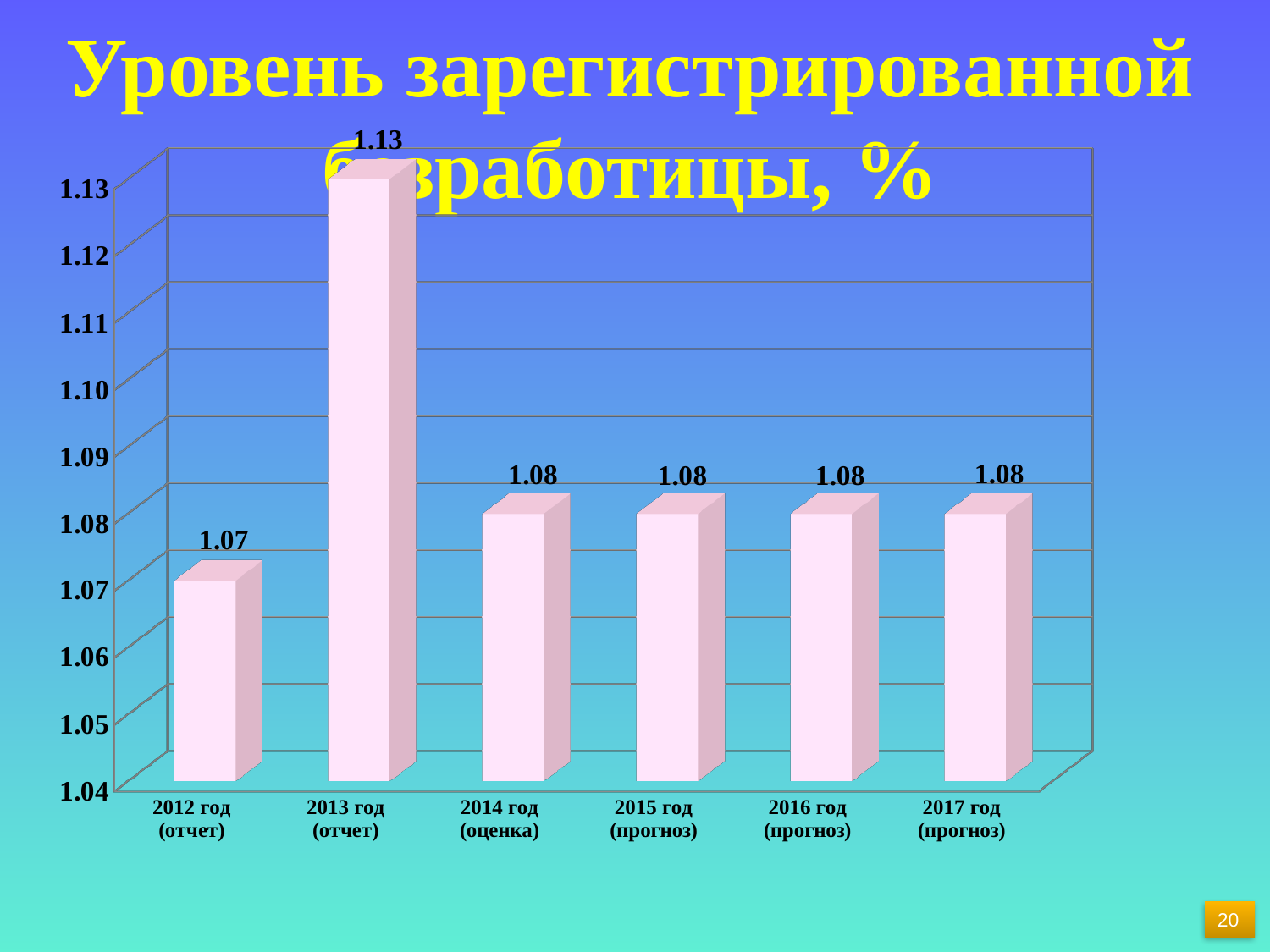
What is the value for 2013 год (отчет)? 1.13 What is the difference between the values for 2014 год (оценка) and 2012 год (отчет)? 0.01 How many years (categories) are shown on the chart? 6 Is the value for 2013 год (отчет) greater or less than 1.10? greater What is the title of the chart? Уровень зарегистрированной безработицы, % What kind of chart is shown on the slide? bar chart Which year has the highest registered unemployment rate? 2013 год (отчет) What is the value for 2012 год (отчет)? 1.07 Which is larger, the value for 2013 год (отчет) or the value for 2017 год (прогноз)? 2013 год (отчет) What is the value for 2015 год (прогноз)? 1.08 What is the difference between the values for 2013 год (отчет) and 2014 год (оценка)? 0.05 Which year has the lowest registered unemployment rate? 2012 год (отчет)